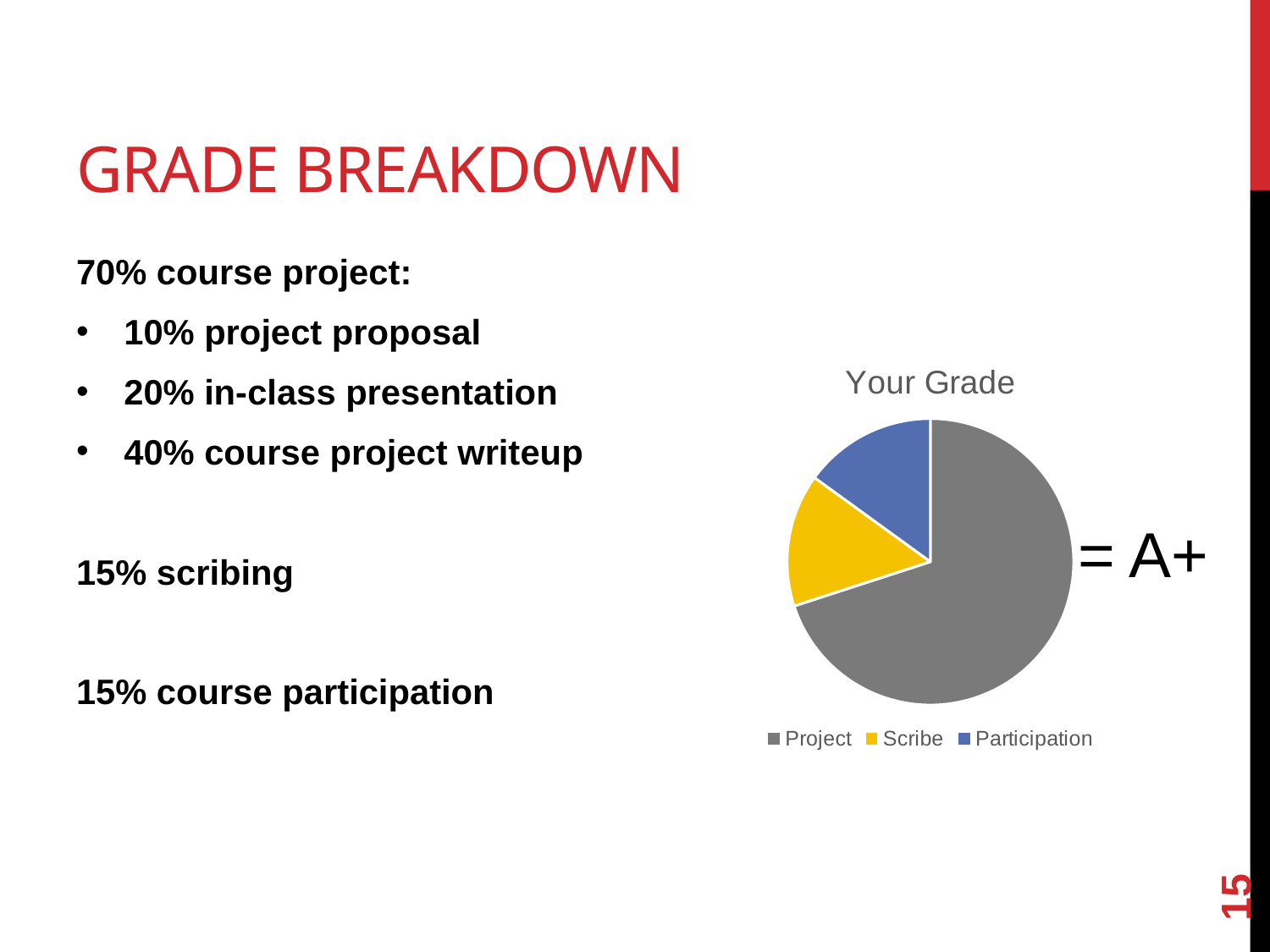
Which colour represents Scribe in the pie chart? yellow What is the title of the chart? Your Grade What kind of chart is shown on the slide? pie chart Which slice is larger, Project or Participation? Project Does the Project slice take up more or less than half of the pie? more How many slices does the pie chart have? 3 How many entries does the chart legend list? 3 Which category has the largest slice of the pie? Project Which slice is larger, Project or Scribe? Project